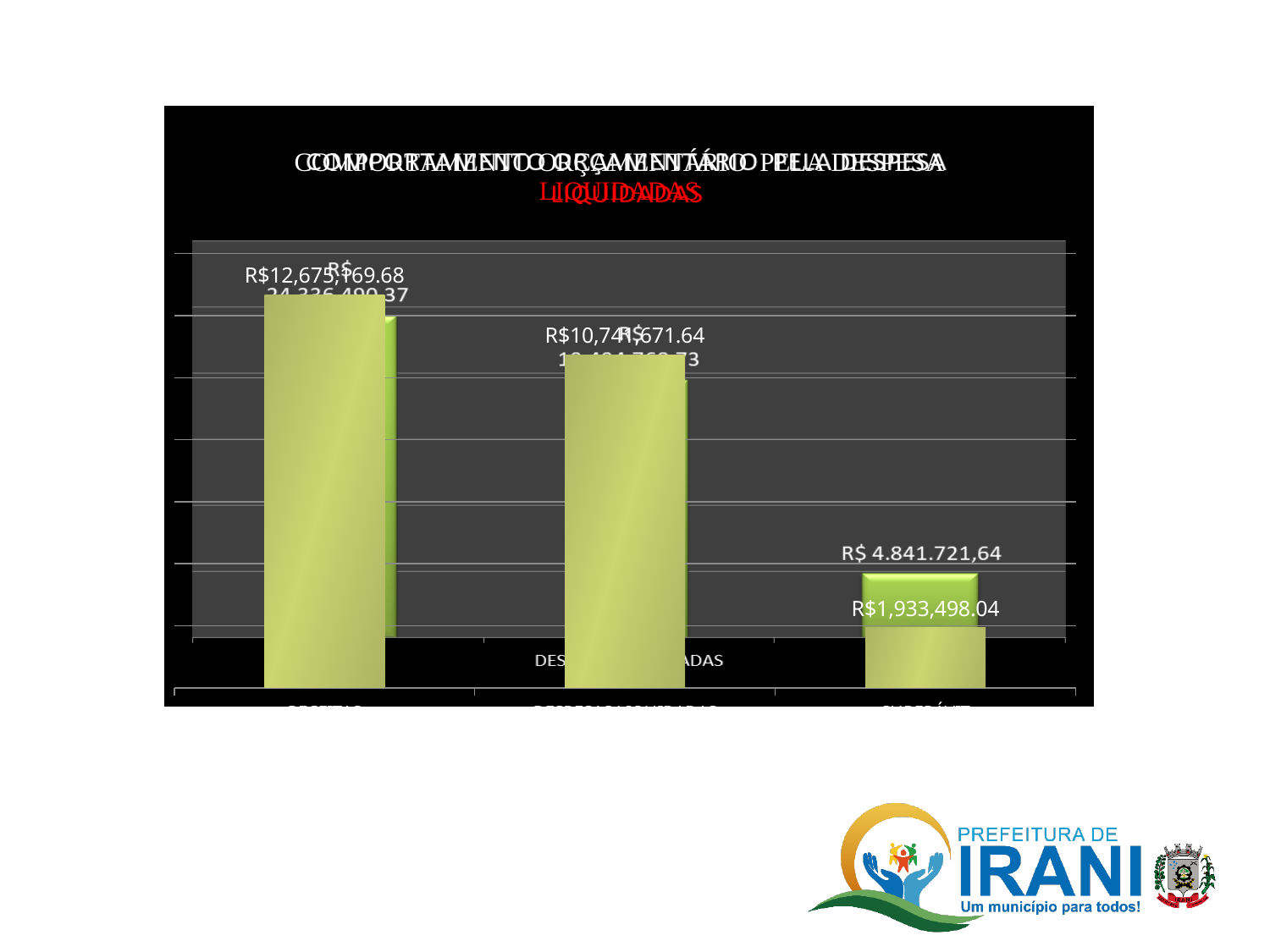
What colour are the bars in the chart? green How many categories (bar positions) does the chart show? 3 What kind of chart is shown on the slide? bar chart Which bar position is the shortest in the chart: left, middle or right? right Is the left bar larger or smaller than the right bar? larger What value label is printed at the top of the leftmost bar in the front chart? R$12,675,169.68 What is the lower of the two value labels printed near the rightmost bar? R$1,933,498.04 What is the upper of the two value labels printed near the rightmost bar? R$ 4.841.721,64 What is the value label 'R$ 4.841.721,64' attached to: the left, middle or right bar? right Do the bar values rise or fall from left to right across the chart? fall What word appears in red below the chart title? LIQUIDADAS Which bar position is the tallest in the chart: left, middle or right? left